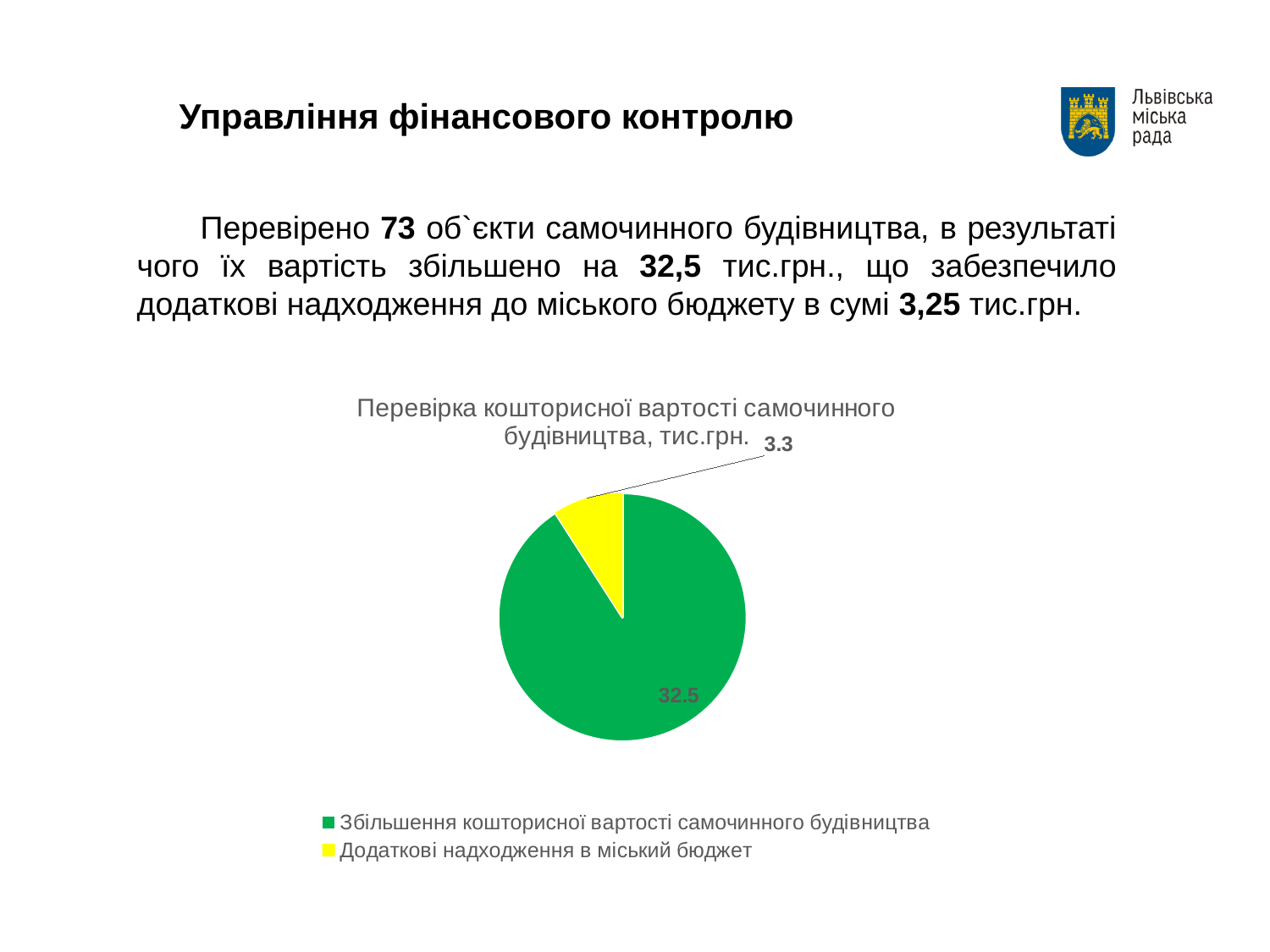
What colour is the slice for "Додаткові надходження в міський бюджет"? Yellow How many slices does the pie chart have? 2 What is the title of the pie chart? Перевірка кошторисної вартості самочинного будівництва, тис.грн. Which category has the smallest slice in the pie chart? Додаткові надходження в міський бюджет What is the value of the slice for "Додаткові надходження в міський бюджет"? 3.3 What is the total of the two slice values in the pie chart? 35.8 Which category has the largest slice in the pie chart? Збільшення кошторисної вартості самочинного будівництва What is the difference between the two slice values in the pie chart? 29.2 How many entries does the legend of the pie chart list? 2 What is the value of the slice for "Збільшення кошторисної вартості самочинного будівництва"? 32.5 Which is larger: the slice for "Збільшення кошторисної вартості самочинного будівництва" or the slice for "Додаткові надходження в міський бюджет"? Збільшення кошторисної вартості самочинного будівництва What kind of chart is shown on the slide? Pie chart